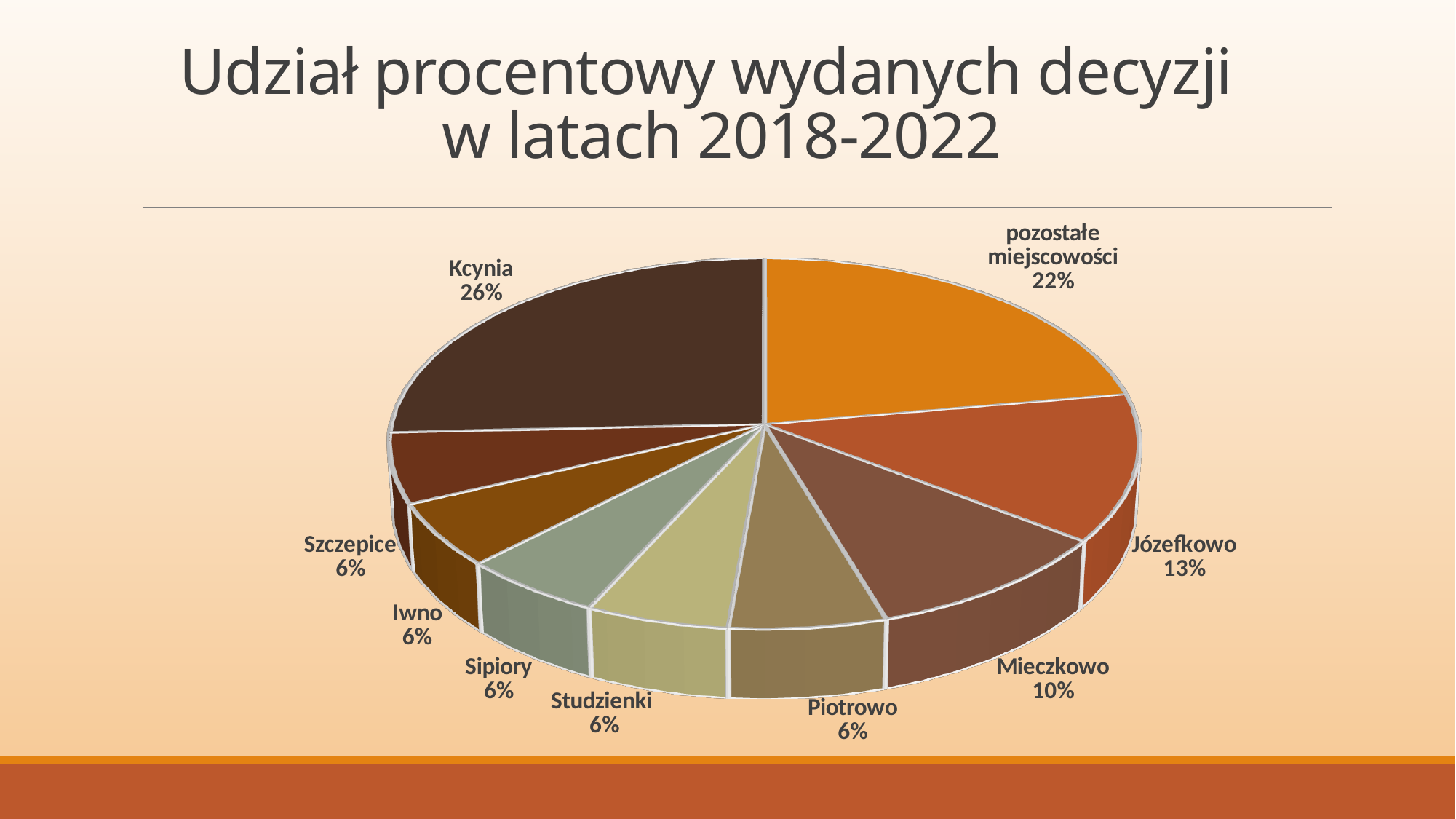
What share of the pie does pozostałe miejscowości have? 22% What is the difference between the shares of Józefkowo and Szczepice? 7% Which category has the largest slice of the pie? Kcynia What is the value shown for Piotrowo? 6% What is the difference between the shares of Kcynia and pozostałe miejscowości? 4% What kind of chart is shown on the slide? pie chart What is the value shown for Mieczkowo? 10% Which is larger, the share of Józefkowo or the share of Mieczkowo? Józefkowo What is the value shown for Józefkowo? 13% What is the title of the chart on the slide? Udział procentowy wydanych decyzji w latach 2018-2022 What share of the pie does Kcynia have? 26% How many slices does the pie chart have? 9